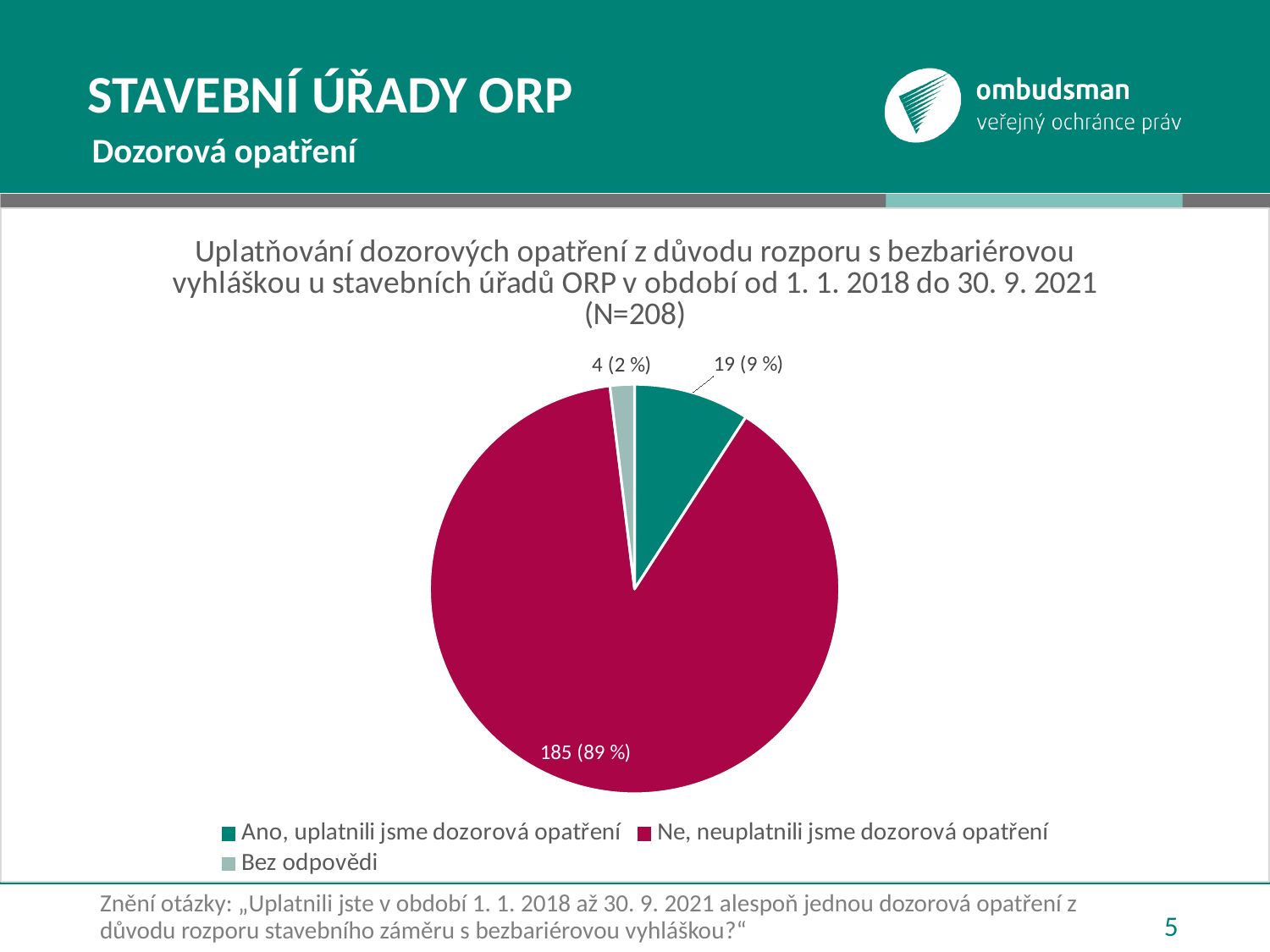
What value is shown for the slice "Ano, uplatnili jsme dozorová opatření"? 19 (9 %) How many slices does the pie chart have? 3 What is the difference in count between "Ne, neuplatnili jsme dozorová opatření" and "Ano, uplatnili jsme dozorová opatření"? 166 Which category has the largest slice of the pie? Ne, neuplatnili jsme dozorová opatření What value is shown for the slice "Ne, neuplatnili jsme dozorová opatření"? 185 (89 %) What value is shown for the slice "Bez odpovědi"? 4 (2 %) Which is larger: the count for "Ano, uplatnili jsme dozorová opatření" or for "Bez odpovědi"? Ano, uplatnili jsme dozorová opatření What share of the pie does the slice "Ano, uplatnili jsme dozorová opatření" represent? 9 % How many entries does the legend of the pie chart list? 3 What kind of chart is shown on the slide? pie chart Which category has the smallest slice of the pie? Bez odpovědi What is the N value stated in the chart title? N=208